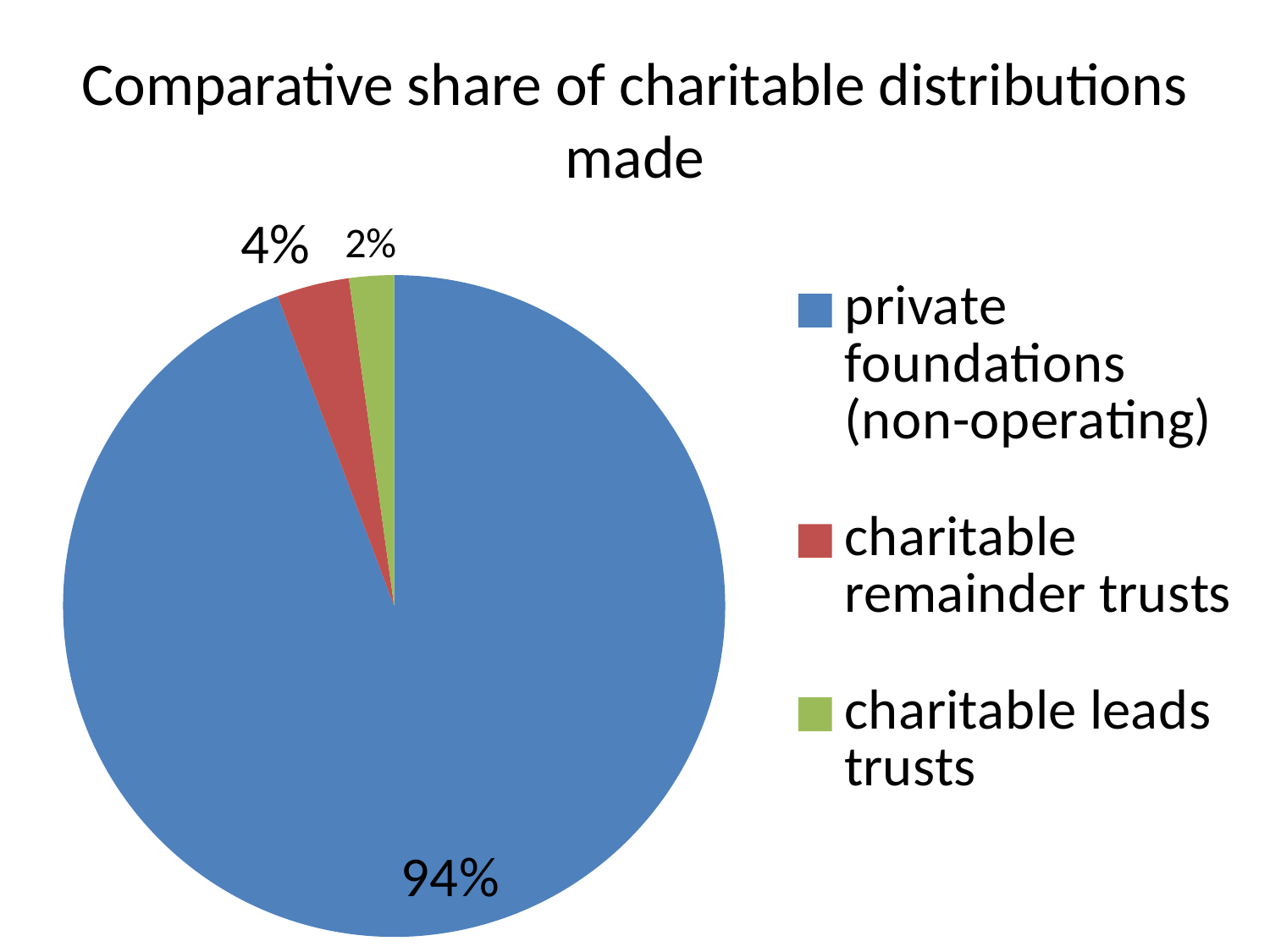
What is the difference in percentage points between the share for charitable remainder trusts and the share for charitable leads trusts? 2 percentage points Which has a larger share: charitable remainder trusts or charitable leads trusts? charitable remainder trusts Which category has the largest share of charitable distributions? private foundations (non-operating) What is the difference in percentage points between the share for private foundations (non-operating) and the share for charitable remainder trusts? 90 percentage points How many categories are shown in the pie chart? 3 What share of charitable distributions is made by charitable leads trusts? 2% Which colour represents charitable remainder trusts in the pie chart? red What share of charitable distributions is made by charitable remainder trusts? 4% Which category has the smallest share of charitable distributions? charitable leads trusts What share of charitable distributions is made by private foundations (non-operating)? 94% What is the title of the chart? Comparative share of charitable distributions made What kind of chart is shown on the slide? pie chart